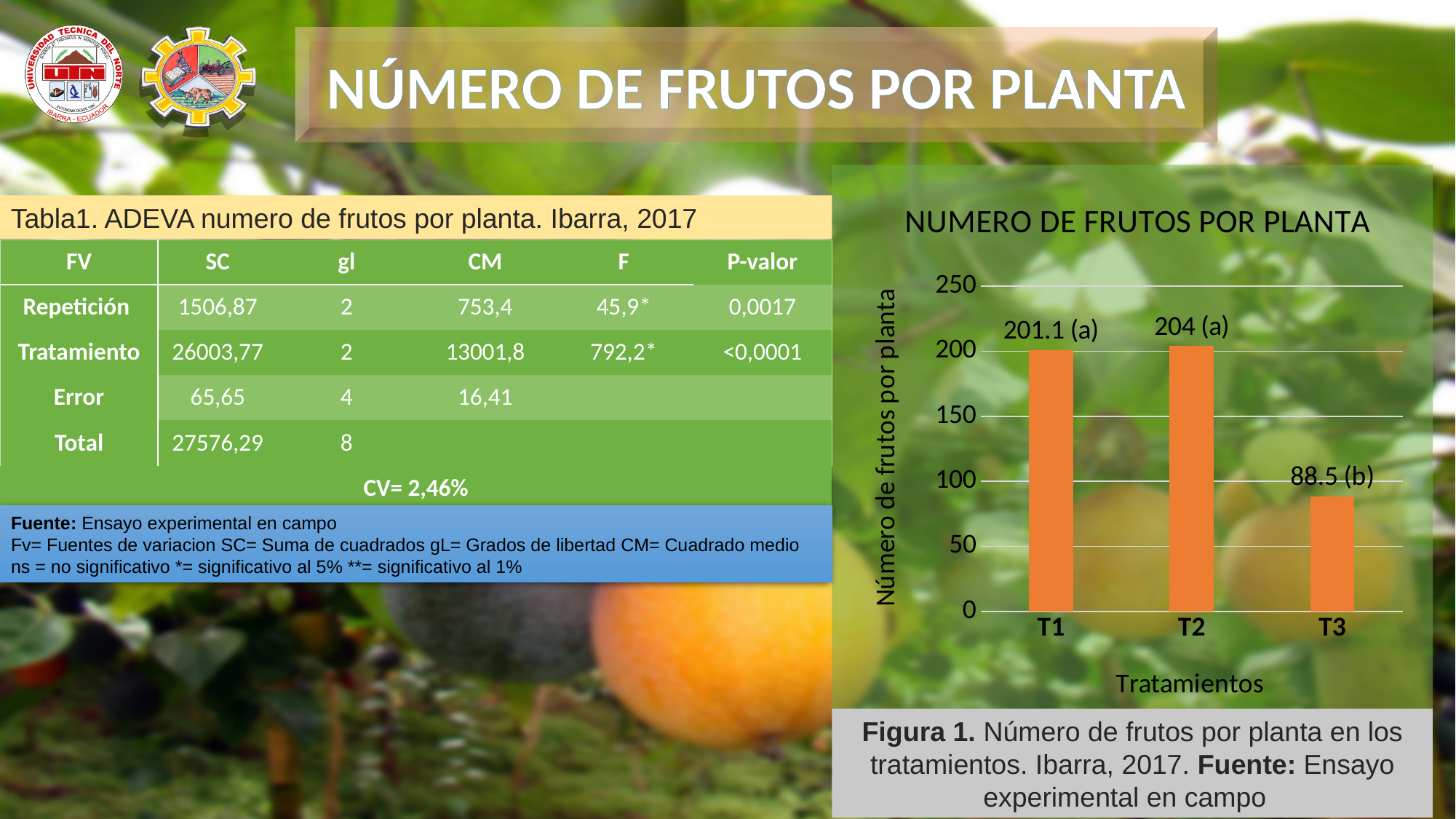
What is the difference between the values for T2 and T3? 115.5 What is the value for T1 in the chart? 201.1 (a) What is the title of the chart? NUMERO DE FRUTOS POR PLANTA Which is larger, the value for T1 or the value for T3? T1 What is the value for T2 in the chart? 204 (a) Is the value for T3 greater or less than 100? less How many treatments are shown on the x axis of the chart? 3 What is the difference between the values for T1 and T3? 112.6 What is the value for T3 in the chart? 88.5 (b) Which treatment has the lowest number of fruits per plant? T3 Is the value for T2 greater or less than 200? greater What kind of chart is shown on the slide? bar chart